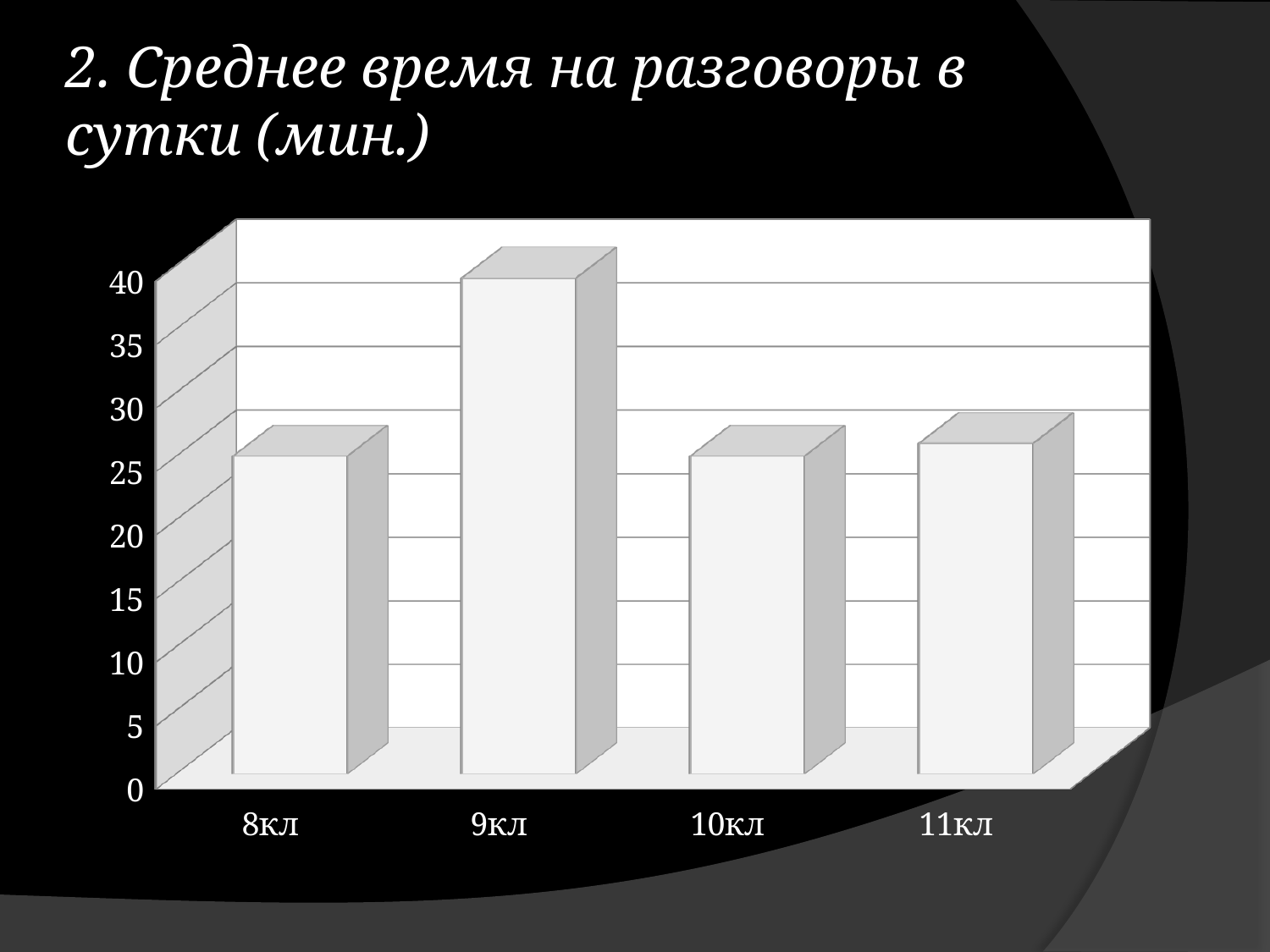
What is the title of the slide containing the chart? 2. Среднее время на разговоры в сутки (мин.) Is the value for 8кл greater or less than 35? less Does the value rise or fall from 9кл to 10кл? fall Is the value for 8кл greater or less than 20? greater How many categories are shown on the x axis of the chart? 4 Is the value for 10кл greater or less than 30? less Which category has the highest value in the chart? 9кл What kind of chart is shown on the slide? bar chart Which is larger, the value for 9кл or the value for 11кл? 9кл Which is larger, the value for 9кл or the value for 10кл? 9кл